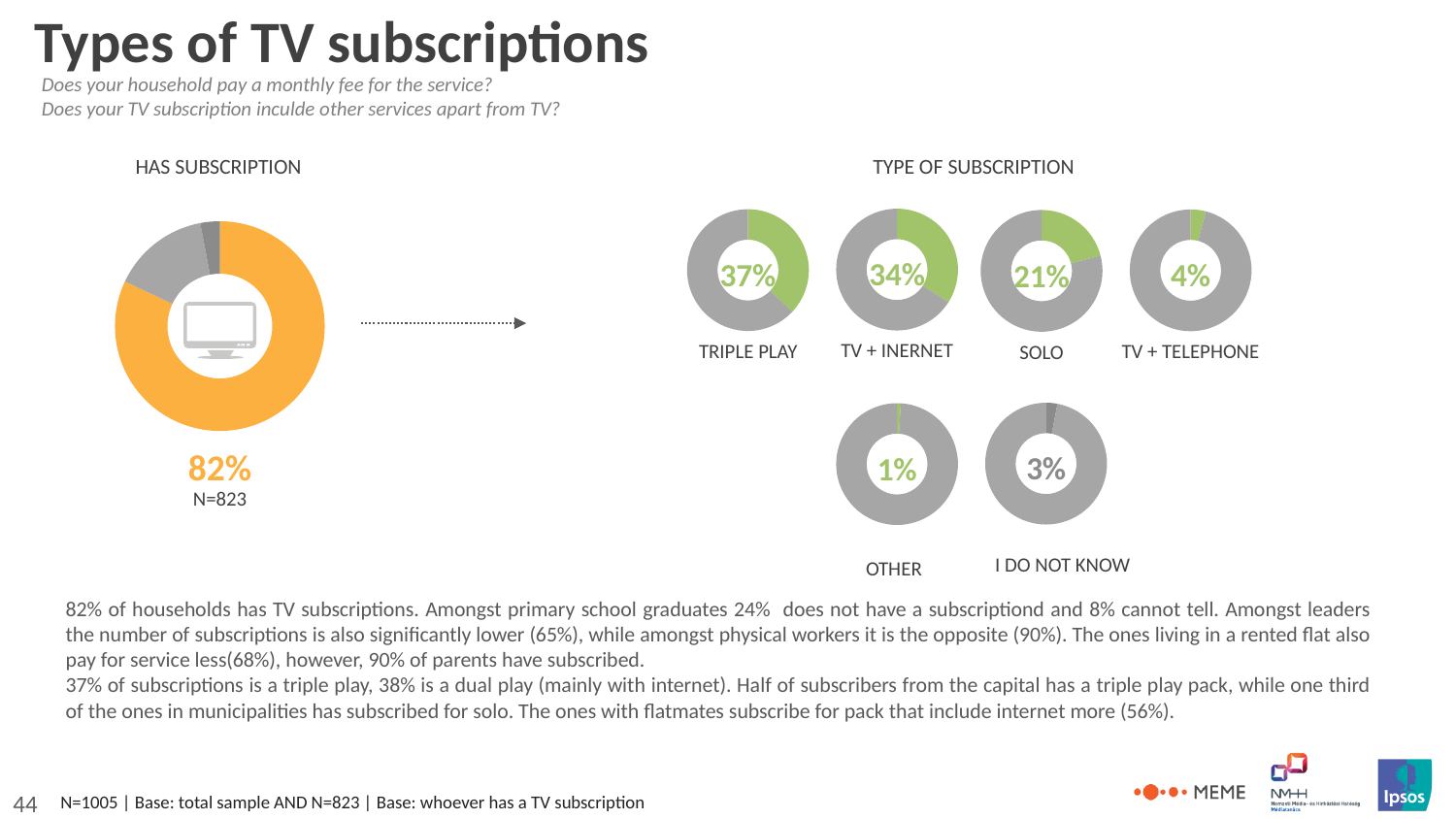
In the TYPE OF SUBSCRIPTION charts, what is the value for TRIPLE PLAY? 37% In the HAS SUBSCRIPTION chart, what percentage of households has a TV subscription? 82% In the TYPE OF SUBSCRIPTION charts, which category has the lowest value? OTHER In the TYPE OF SUBSCRIPTION charts, what is the value for I DO NOT KNOW? 3% How many donut charts are shown under the TYPE OF SUBSCRIPTION heading? 6 What kind of chart is used for HAS SUBSCRIPTION? Donut (pie) chart In the TYPE OF SUBSCRIPTION charts, what is the value for TV + TELEPHONE? 4% In the TYPE OF SUBSCRIPTION charts, which subscription type has the highest value? TRIPLE PLAY In the TYPE OF SUBSCRIPTION charts, what is the difference between TRIPLE PLAY and TV + INERNET? 3% In the HAS SUBSCRIPTION chart, what is the sample size (N) shown below the donut? N=823 In the TYPE OF SUBSCRIPTION charts, what is the value for SOLO? 21% In the TYPE OF SUBSCRIPTION charts, which is larger, SOLO or TV + TELEPHONE? SOLO